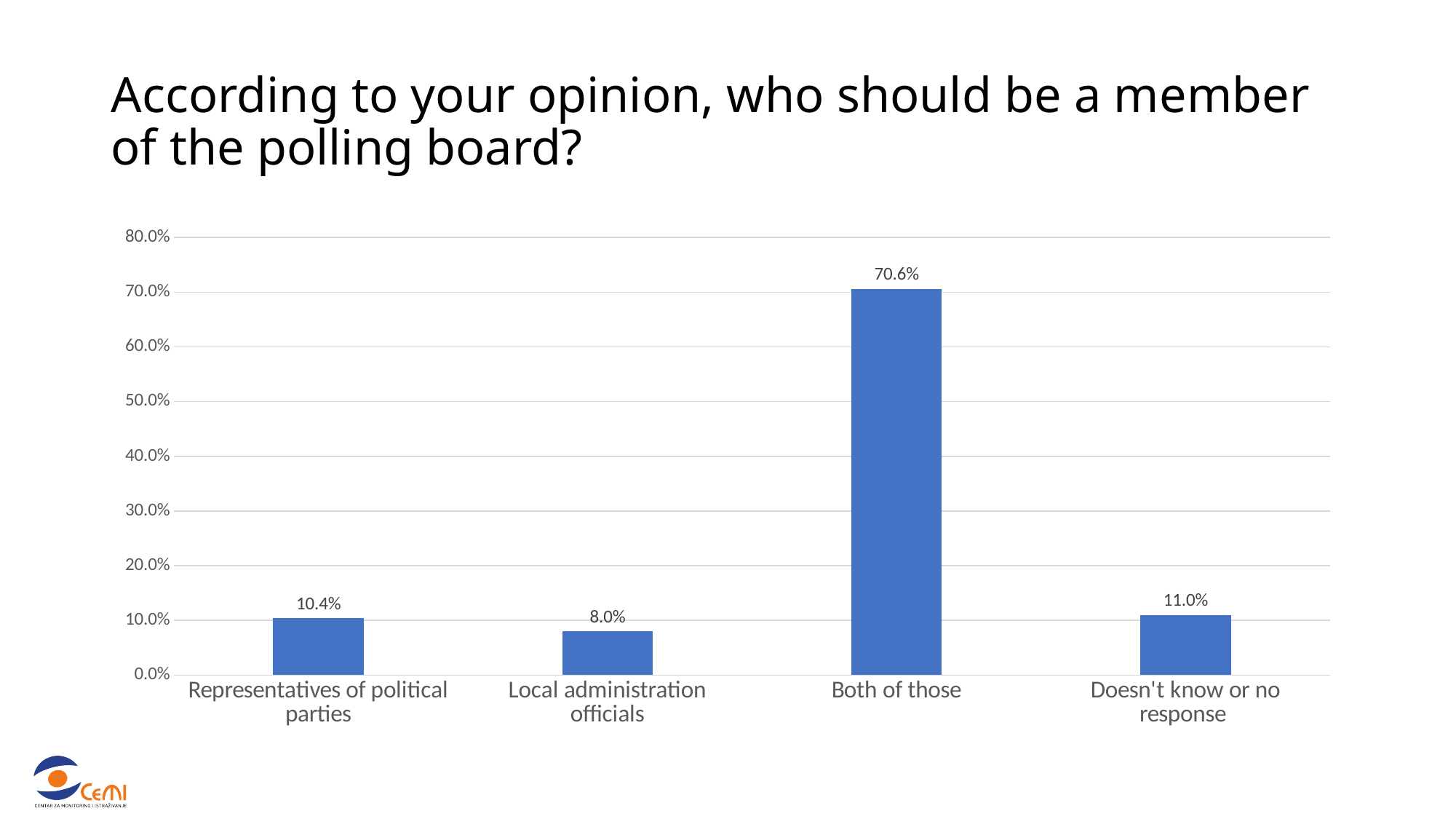
What kind of chart is shown on the slide? Bar chart What is the value for Representatives of political parties? 10.4% What is the difference between the values for Representatives of political parties and Local administration officials? 2.4% What is the value for Doesn't know or no response? 11.0% What is the difference between the values for Both of those and Doesn't know or no response? 59.6% What is the value for Local administration officials? 8.0% Which is larger: the value for Doesn't know or no response or the value for Representatives of political parties? Doesn't know or no response Which category has the highest value? Both of those What percentage of respondents said both of those should be members of the polling board? 70.6% How many categories are shown on the chart? 4 Is the value for Both of those greater or less than 70.0%? greater Which category has the lowest value? Local administration officials